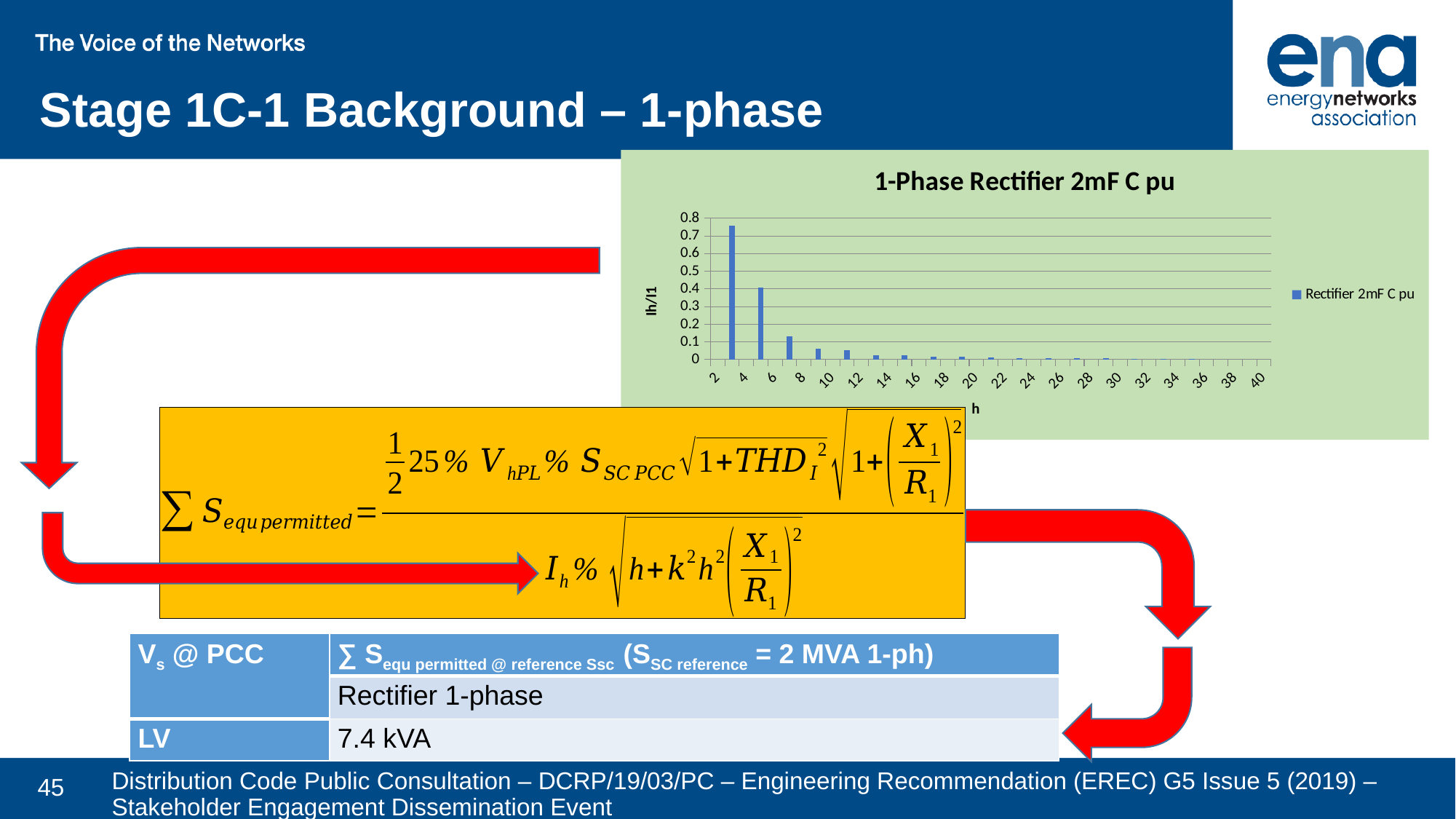
Is the value of the second-tallest bar in the chart greater or less than 0.3? greater Is the value of the second-tallest bar in the chart greater or less than 0.5? less How many series does the chart legend list? 1 Is the value of the bar near h=8 greater or less than 0.2? less Do the bar values generally rise or fall as h increases along the x axis? fall What is the title of the chart? 1-Phase Rectifier 2mF C pu What is the label on the vertical axis of the chart? Ih/I1 What kind of chart is shown on the slide? bar chart Which is larger: the first bar (near h=2) or the second bar (near h=4)? the first bar What is the highest value shown on the vertical axis of the chart? 0.8 What is the highest tick label shown on the horizontal axis of the chart? 40